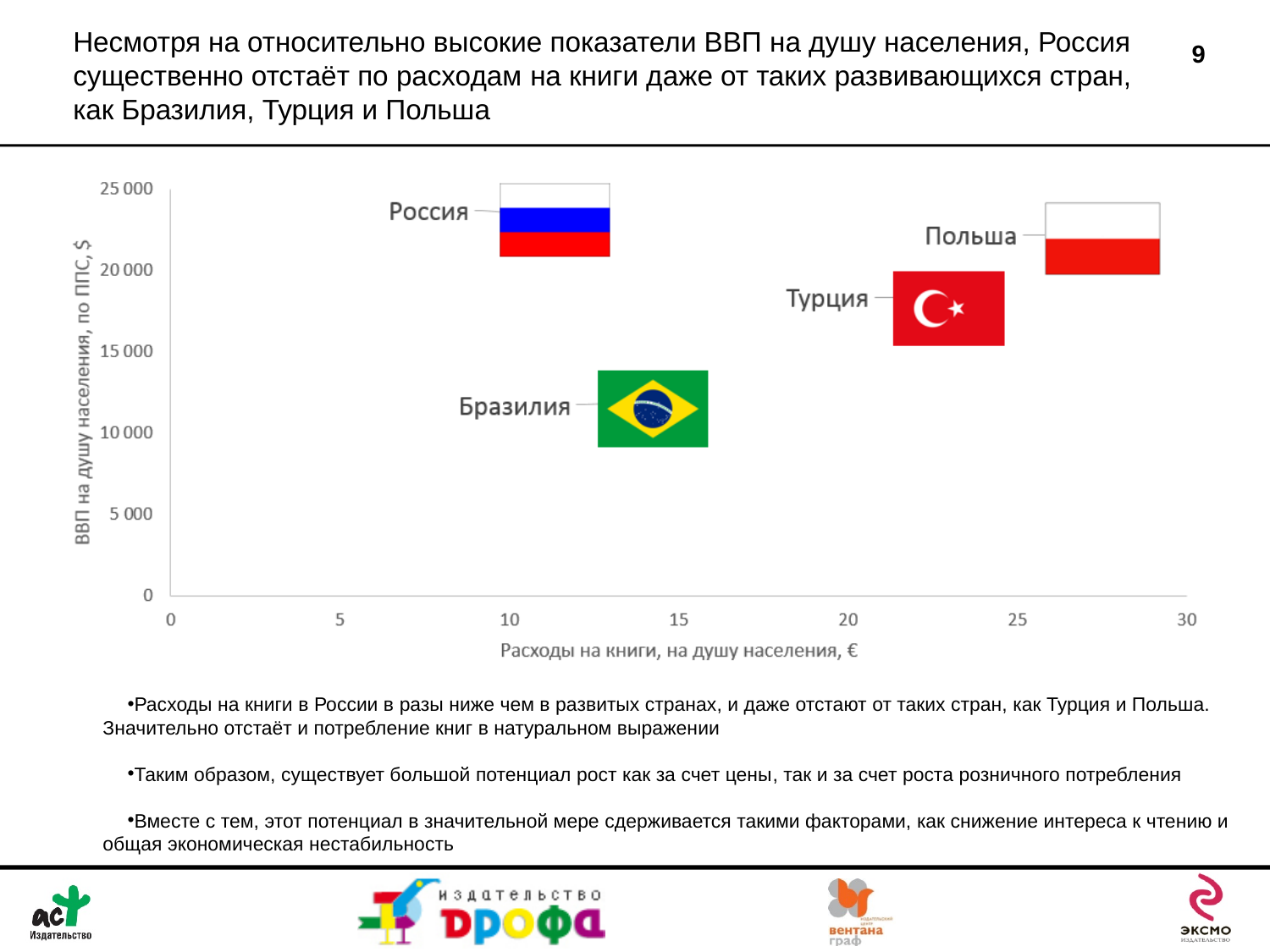
Is the book spending per capita for Турция greater or less than 20? greater Is the GDP per capita for Бразилия greater or less than 15 000? less How many countries are plotted on the chart? 4 Is the book spending per capita for Польша greater or less than 25? greater Which country has the lowest book spending per capita (x axis)? Россия Which country has higher GDP per capita, Россия or Бразилия? Россия Which country has the highest book spending per capita (x axis)? Польша Which country has higher book spending per capita, Бразилия or Турция? Турция Which country has the lowest GDP per capita (y axis)? Бразилия What is the label of the x axis? Расходы на книги, на душу населения, € What kind of chart is shown on the slide? scatter chart